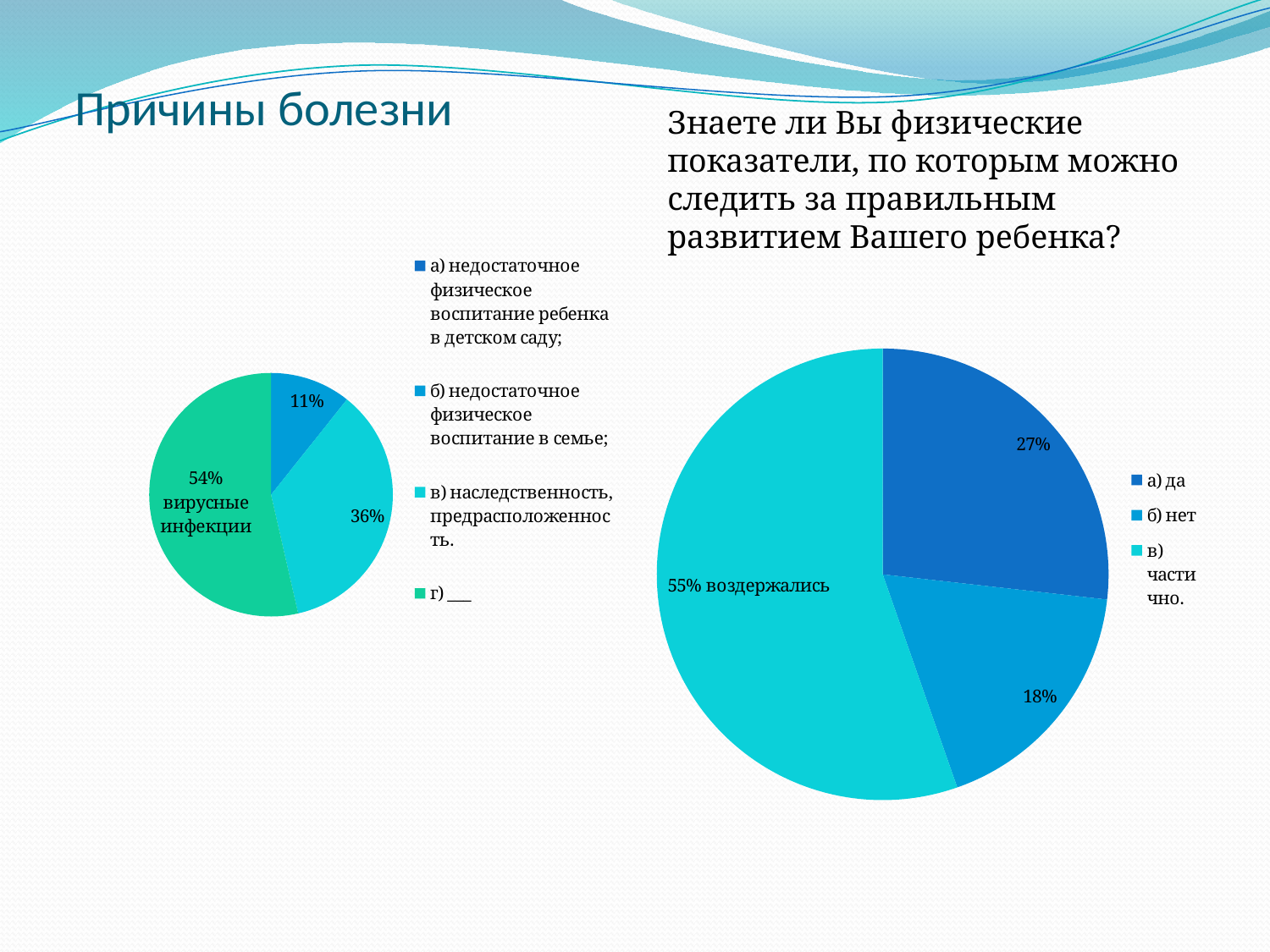
What are the three legend entries of the right pie chart? а) да, б) нет, в) частично How many slices does the right pie chart have? 3 What kind of chart is the left chart titled 'Причины болезни'? Pie chart How many entries does the legend of the left pie chart (Причины болезни) list? 4 In the left pie chart (Причины болезни), what is the largest percentage shown on a slice? 54% In the right pie chart, which is larger: the 27% slice or the 18% slice? The 27% slice In the left pie chart (Причины болезни), what percentage is shown for the slice labelled 'вирусные инфекции'? 54% In the right pie chart, what is the difference between the 55% slice and the 27% slice? 28% In the right pie chart, what percentage is shown for the slice labelled 'воздержались'? 55% In the right pie chart, what is the smallest percentage shown on a slice? 18% In the left pie chart (Причины болезни), what is the smallest percentage shown on a slice? 11% In the left pie chart (Причины болезни), what is the difference between the 54% slice and the 36% slice? 18%